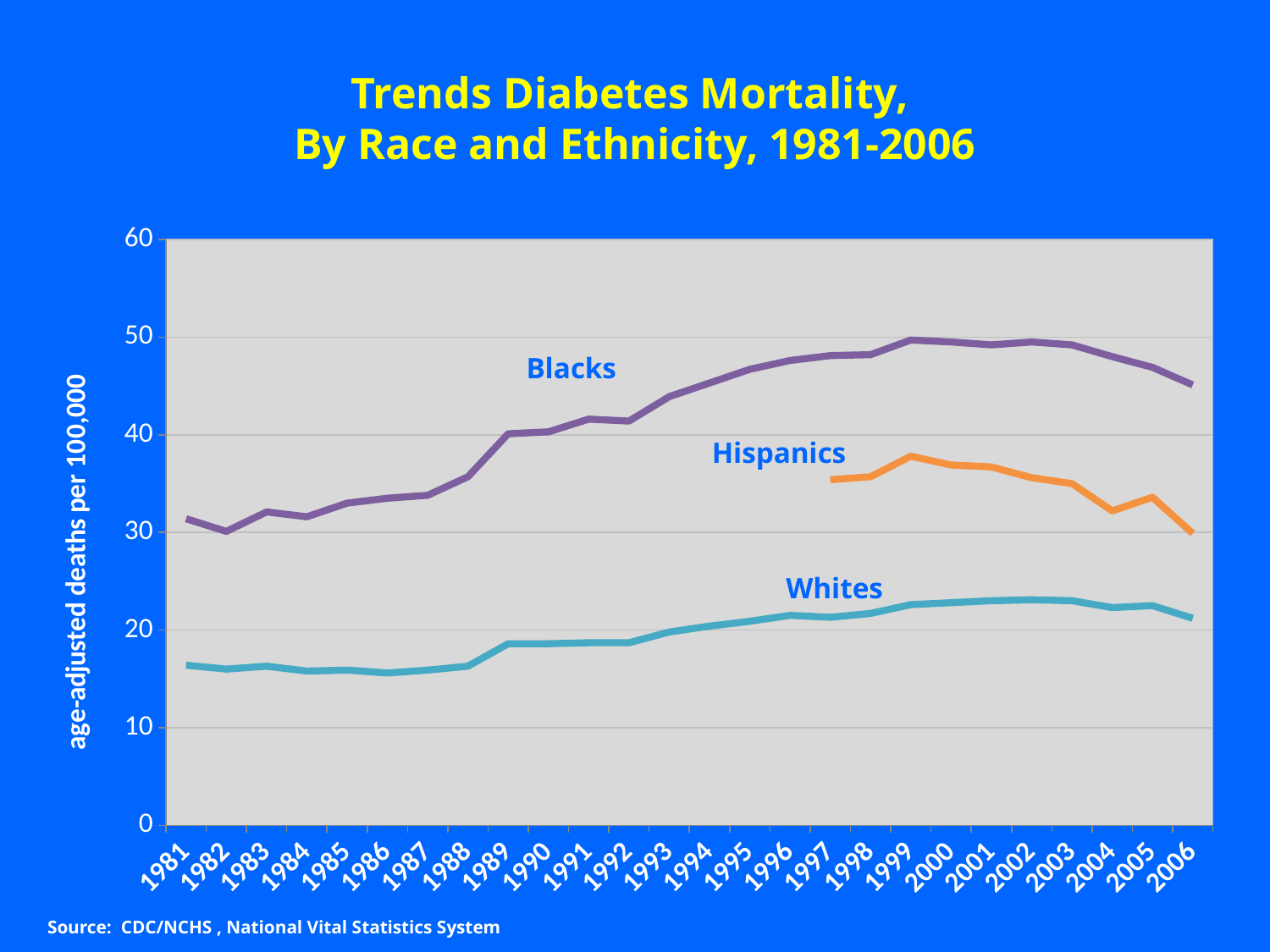
Is the value for Hispanics in 1999 greater or less than 40? less How many series (population groups) are plotted on the chart? 3 What is the label on the y axis? age-adjusted deaths per 100,000 Does the line for Blacks rise or fall between 1981 and 1999? rise In 2000, which is larger: the value for Blacks or the value for Whites? Blacks How many years are shown along the x axis? 26 Is the value for Whites in 1981 greater or less than 20? less Which group has the highest diabetes mortality rate throughout the period shown? Blacks Which group has the lowest diabetes mortality rate throughout the period shown? Whites In 2006, which is larger: the value for Hispanics or the value for Whites? Hispanics What type of chart is shown on the slide? line chart Is the value for Blacks in 1999 greater or less than 40? greater